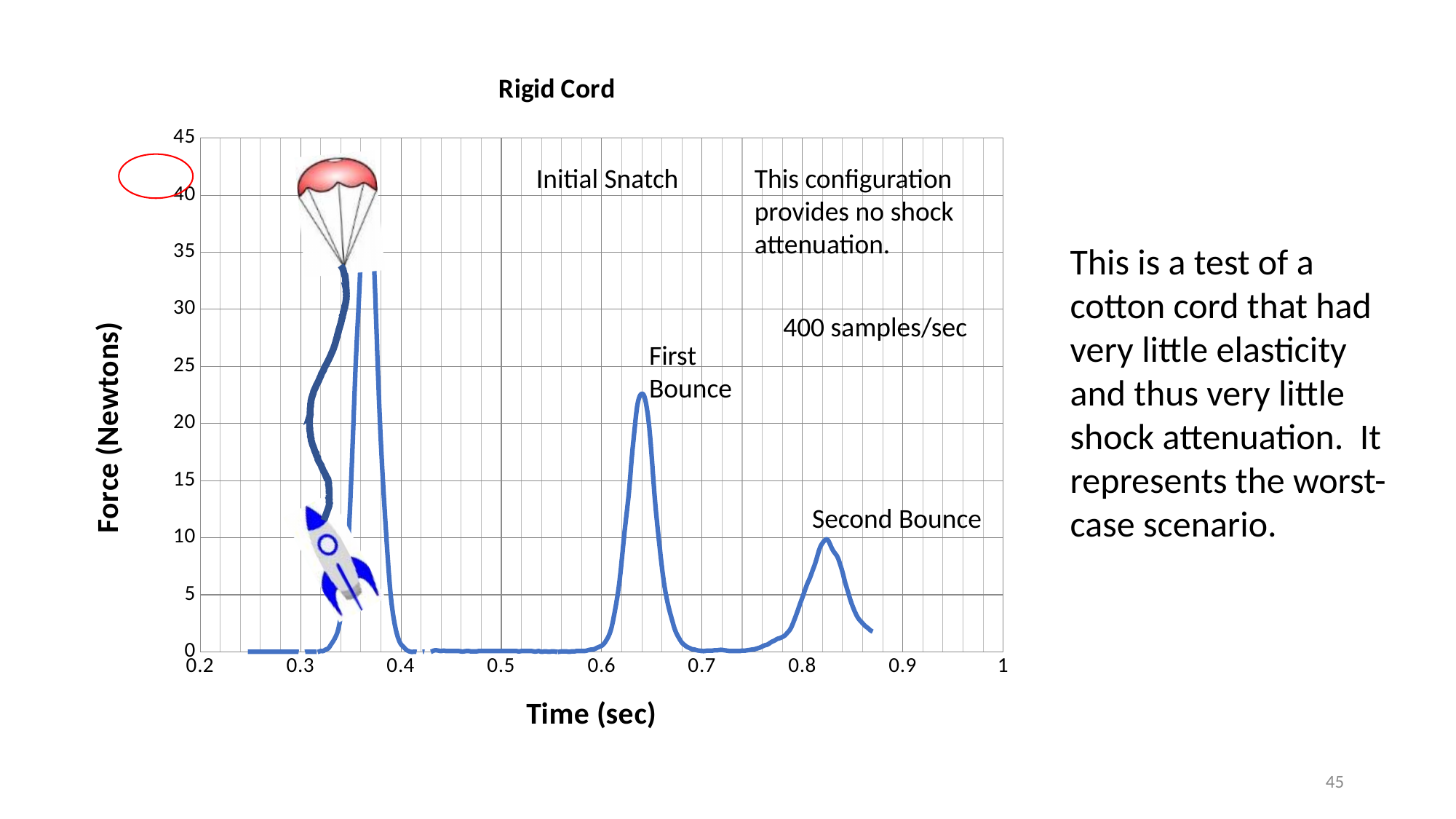
Is the peak force of the First Bounce greater or less than 25 Newtons? less Which peak is larger, First Bounce or Second Bounce? First Bounce Is the peak force of the Second Bounce greater or less than 5 Newtons? greater Is the peak force of the Second Bounce greater or less than 15 Newtons? less What is the title of the chart? Rigid Cord Do the peak forces rise or fall from the Initial Snatch to the Second Bounce along the time axis? fall Which labeled peak has the highest force? Initial Snatch Which labeled peak has the lowest force? Second Bounce How many labeled peaks (events) are marked on the chart? 3 What kind of chart is shown on the slide? line chart What sampling rate is noted on the chart? 400 samples/sec